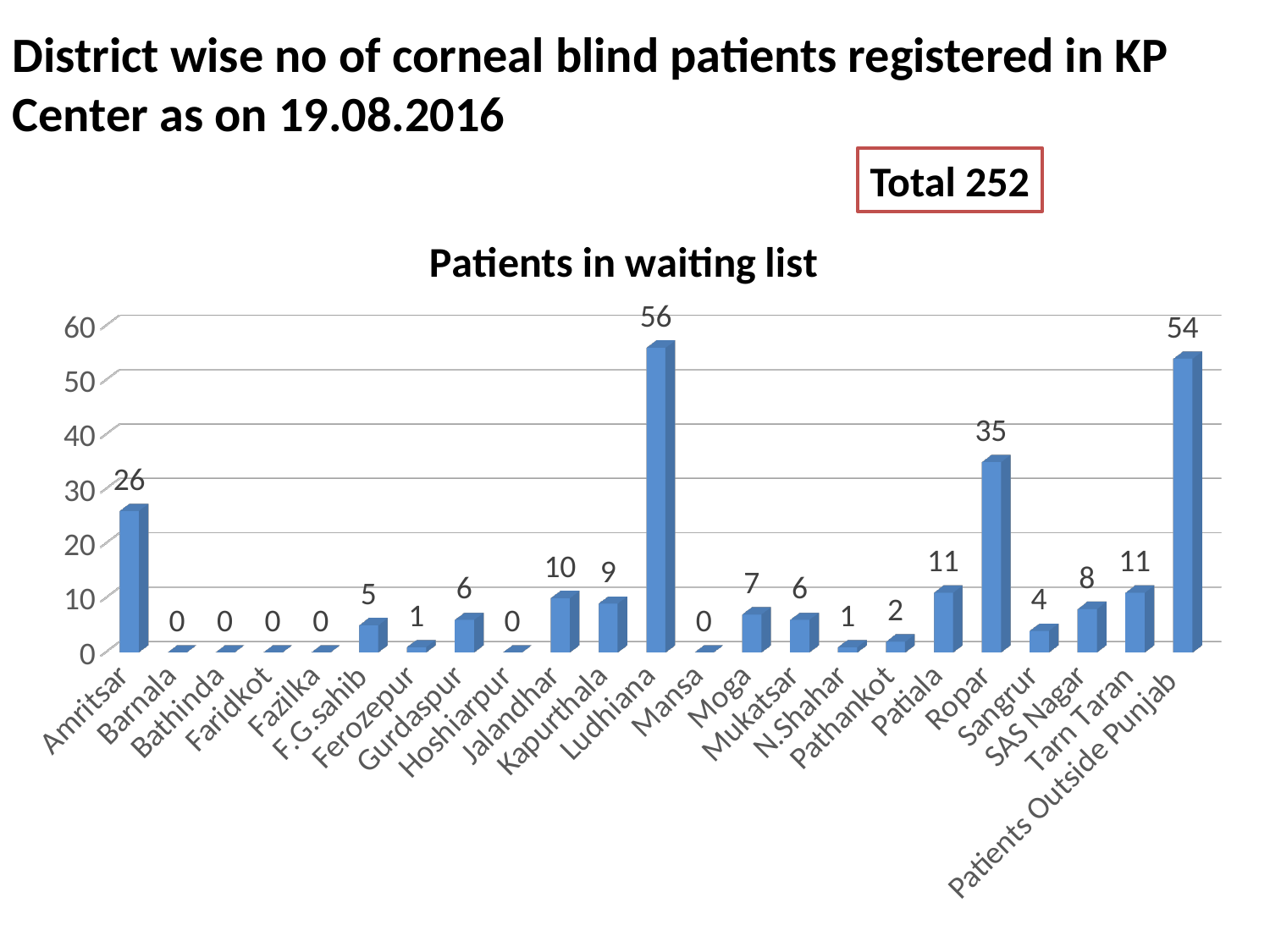
What is the value for Amritsar? 26 What is the title of the chart? Patients in waiting list How many districts have a value of 0 in the chart? 6 How many patients in the waiting list are from Ropar? 35 Which is larger, the value for Jalandhar or the value for Kapurthala? Jalandhar What is the value for Ludhiana in the Patients in waiting list chart? 56 What is the difference between the values for Ropar and Amritsar? 9 What is the value shown for Patients Outside Punjab? 54 What is the difference between the values for Ludhiana and Patients Outside Punjab? 2 How many categories are shown on the x axis of the chart? 23 Which district has the highest number of patients in the waiting list? Ludhiana What kind of chart is shown on the slide? Bar chart